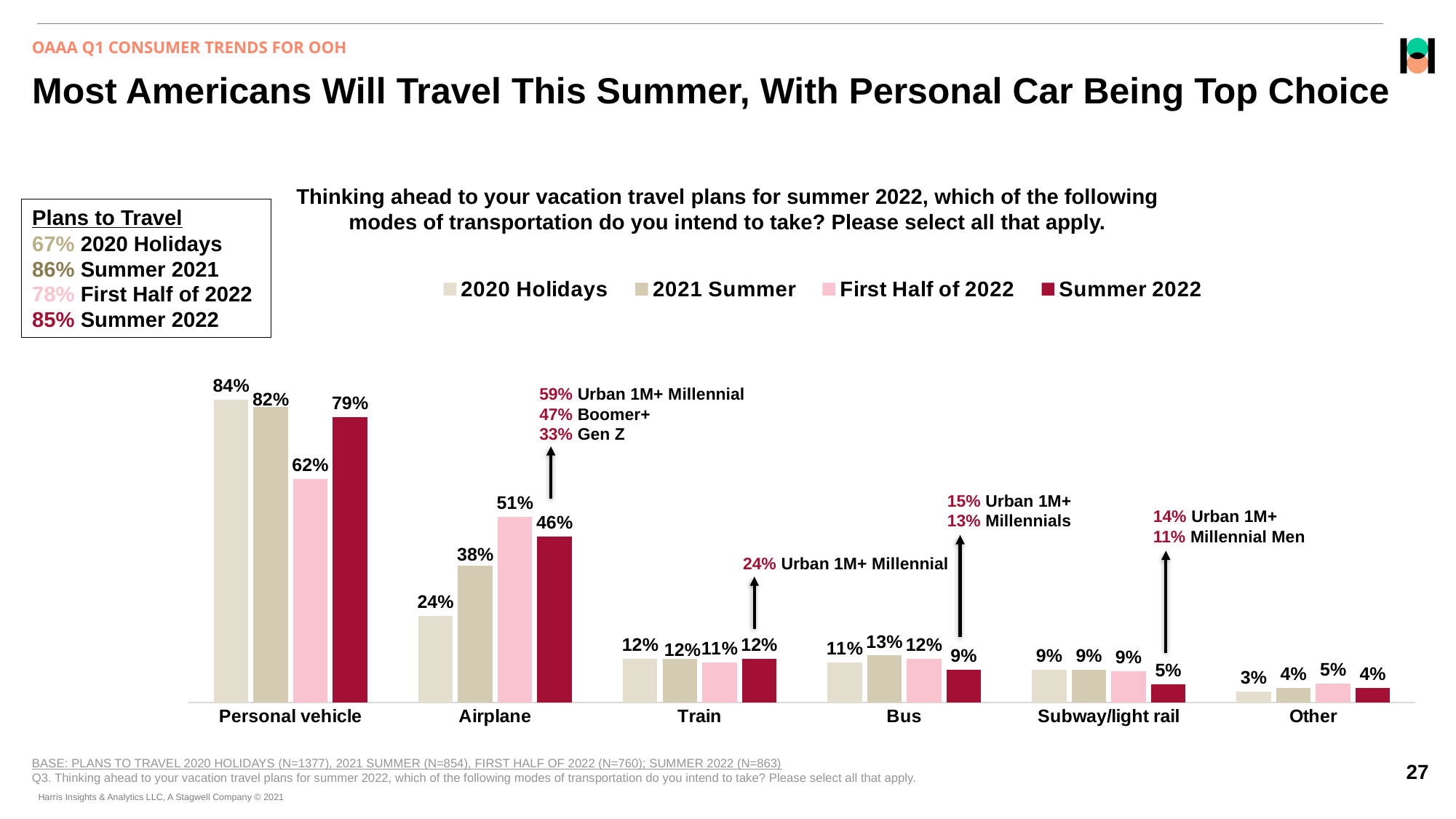
How many series does the legend list? 4 What is the Summer 2022 value for Subway/light rail? 5% What is the First Half of 2022 value for Airplane? 51% What is the difference between the 2020 Holidays and First Half of 2022 values for Personal vehicle? 22% What is the Summer 2022 value for Personal vehicle? 79% How many modes of transportation are shown on the x axis? 6 What kind of chart is shown on the slide? Bar chart Which mode of transportation has the lowest Summer 2022 value? Other What is the 2021 Summer value for Bus? 13% Which is larger for Airplane: the 2021 Summer value or the Summer 2022 value? Summer 2022 What is the difference between the First Half of 2022 and Summer 2022 values for Airplane? 5% Which mode of transportation has the highest 2020 Holidays value? Personal vehicle